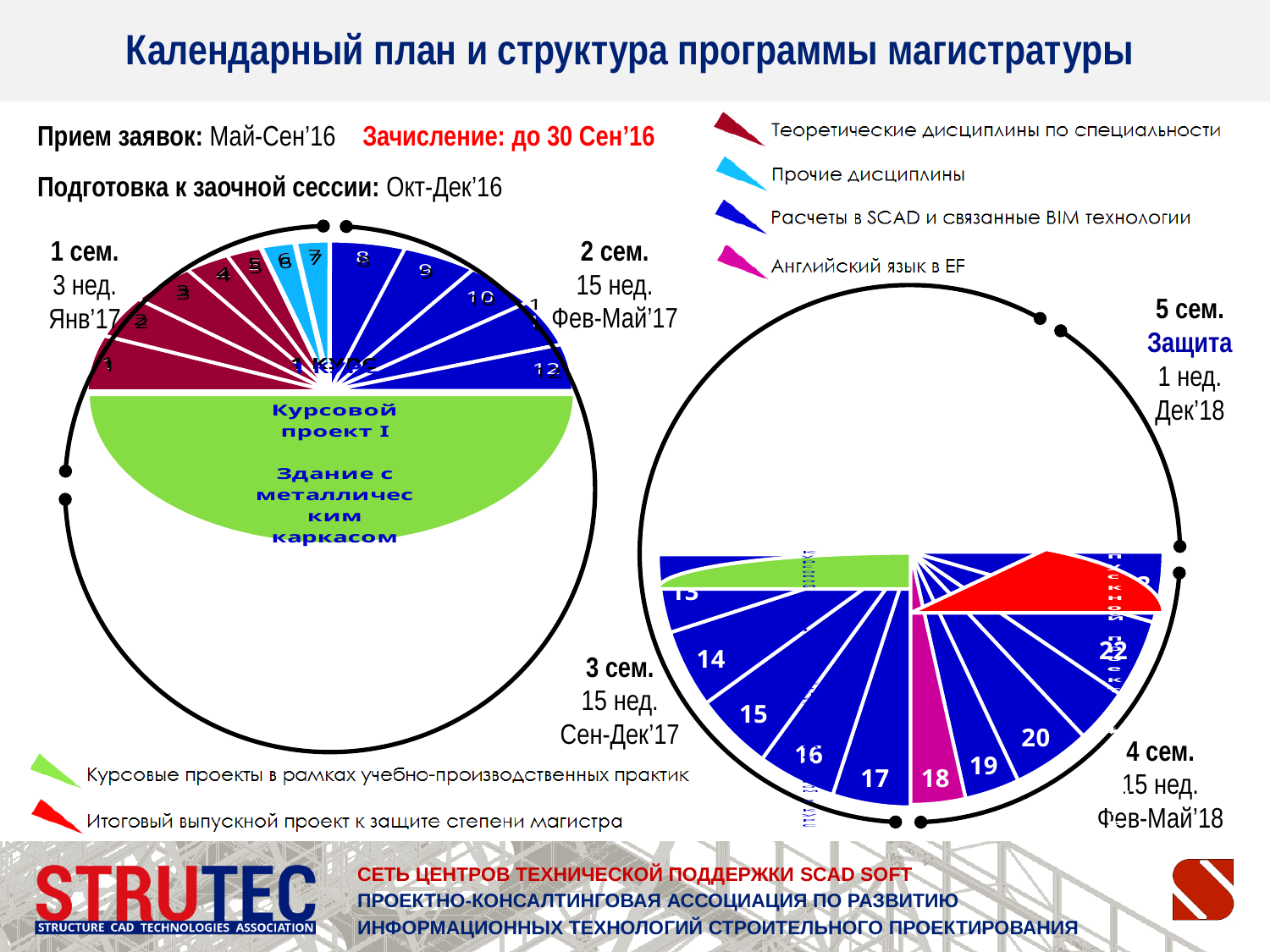
Which is longer, 1 сем. or 3 сем.? 3 сем. In the right circular chart, which numbered segment is coloured magenta (Английский язык в EF)? 18 In the left circular chart (1 курс), how many numbered segments are there? 12 What kind of chart is used for the two circular diagrams on the slide? pie chart How many weeks long is 1 сем. according to the annotation next to the left chart? 3 нед. How many legend entries are shown on the slide in total? 6 How many weeks long is 2 сем. according to the annotation next to the left chart? 15 нед. How many weeks long is 5 сем. (Защита) according to the annotation next to the right chart? 1 нед. Which colour in the legend represents 'Итоговый выпускной проект к защите степени магистра'? red What is the title of the slide? Календарный план и структура программы магистратуры In the left circular chart, which numbered segments are coloured light blue (Прочие дисциплины)? 6 and 7